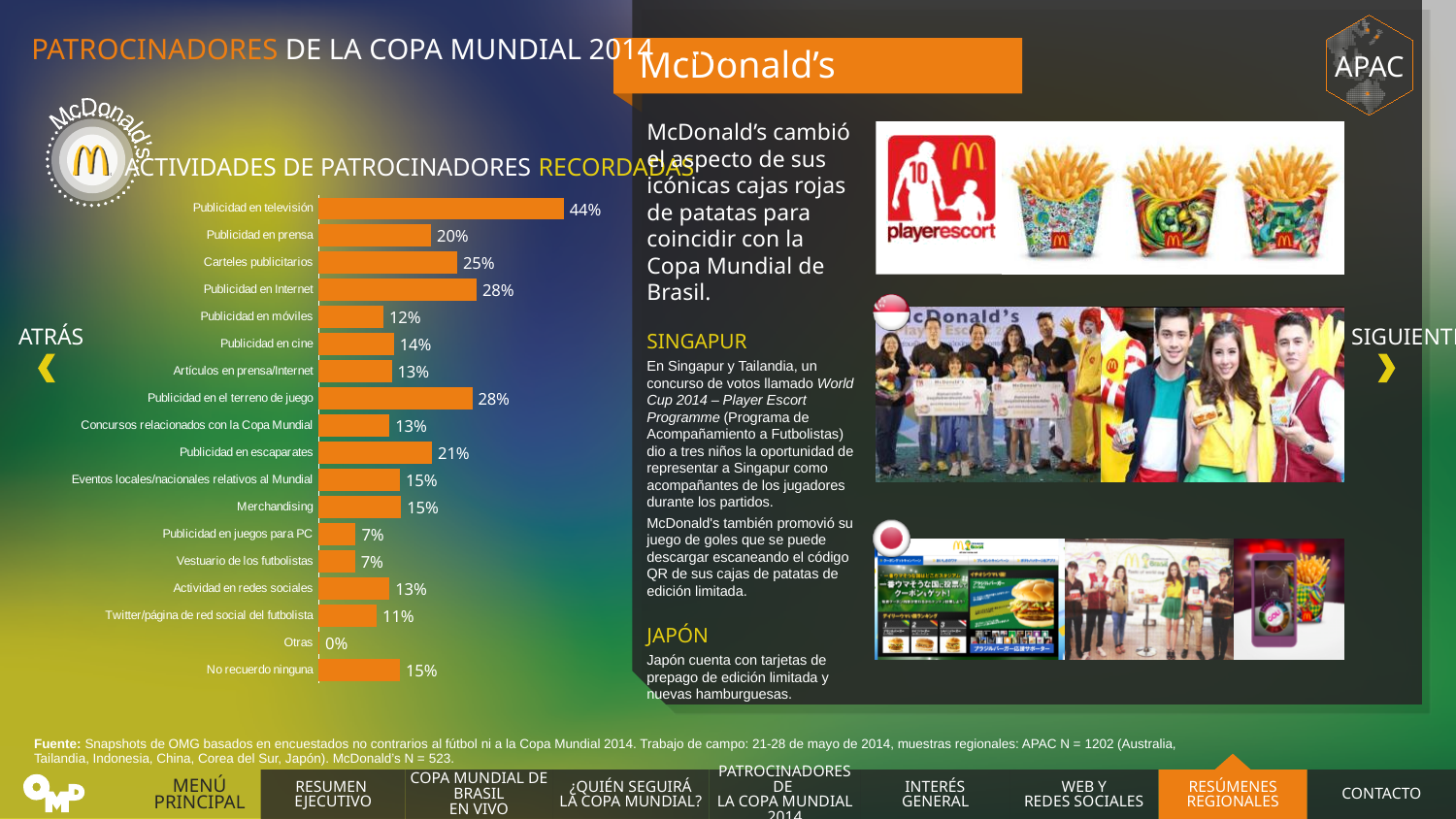
What is the value for Publicidad en televisión? 44% Which category has the lowest value? Otras What is the difference between Carteles publicitarios and Publicidad en prensa? 5% What is the difference between Publicidad en televisión and Publicidad en Internet? 16% How many categories are shown in the chart? 18 Which is larger, Publicidad en cine or Publicidad en móviles? Publicidad en cine What is the value for No recuerdo ninguna? 15% Which category has the highest value? Publicidad en televisión What is the value for Publicidad en escaparates? 21% What type of chart is shown on the slide? Bar chart What is the title of the chart? ACTIVIDADES DE PATROCINADORES RECORDADAS What is the value for Twitter/página de red social del futbolista? 11%